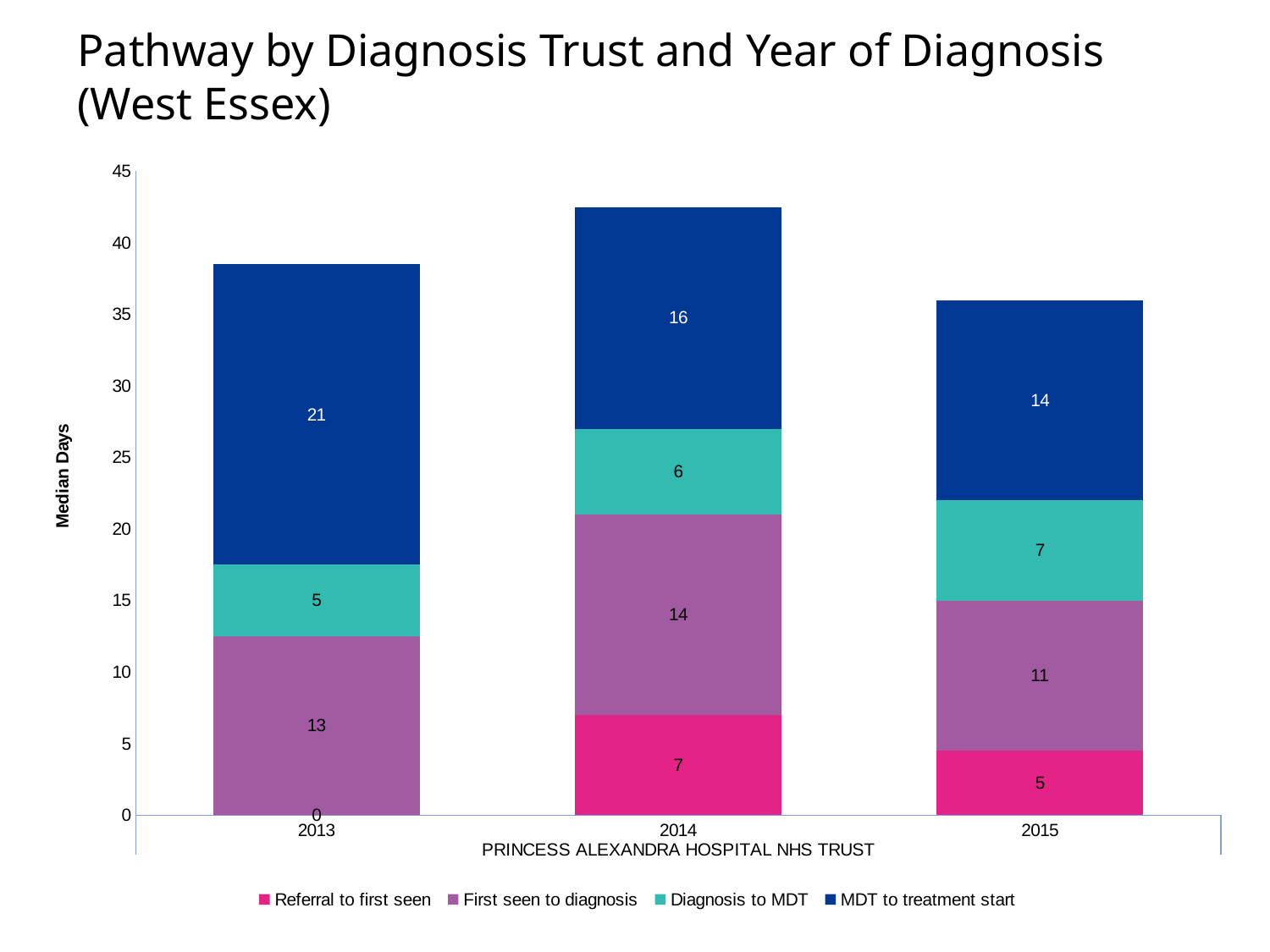
What is the median days value for First seen to diagnosis in 2014? 14 Which is larger, the First seen to diagnosis value for 2014 or for 2015? 2014 What is the median days value for Referral to first seen in 2015? 5 Which year has the highest value for MDT to treatment start? 2013 What is the median days value for Diagnosis to MDT in 2015? 7 What is the total of the stacked bar for 2014? 43 What is the difference between the MDT to treatment start values for 2013 and 2015? 7 What kind of chart is shown on the slide? Stacked bar chart How many series does the legend list? 4 Which year has the lowest value for Referral to first seen? 2013 What is the median days value for MDT to treatment start in 2013? 21 How many years are shown on the x axis? 3